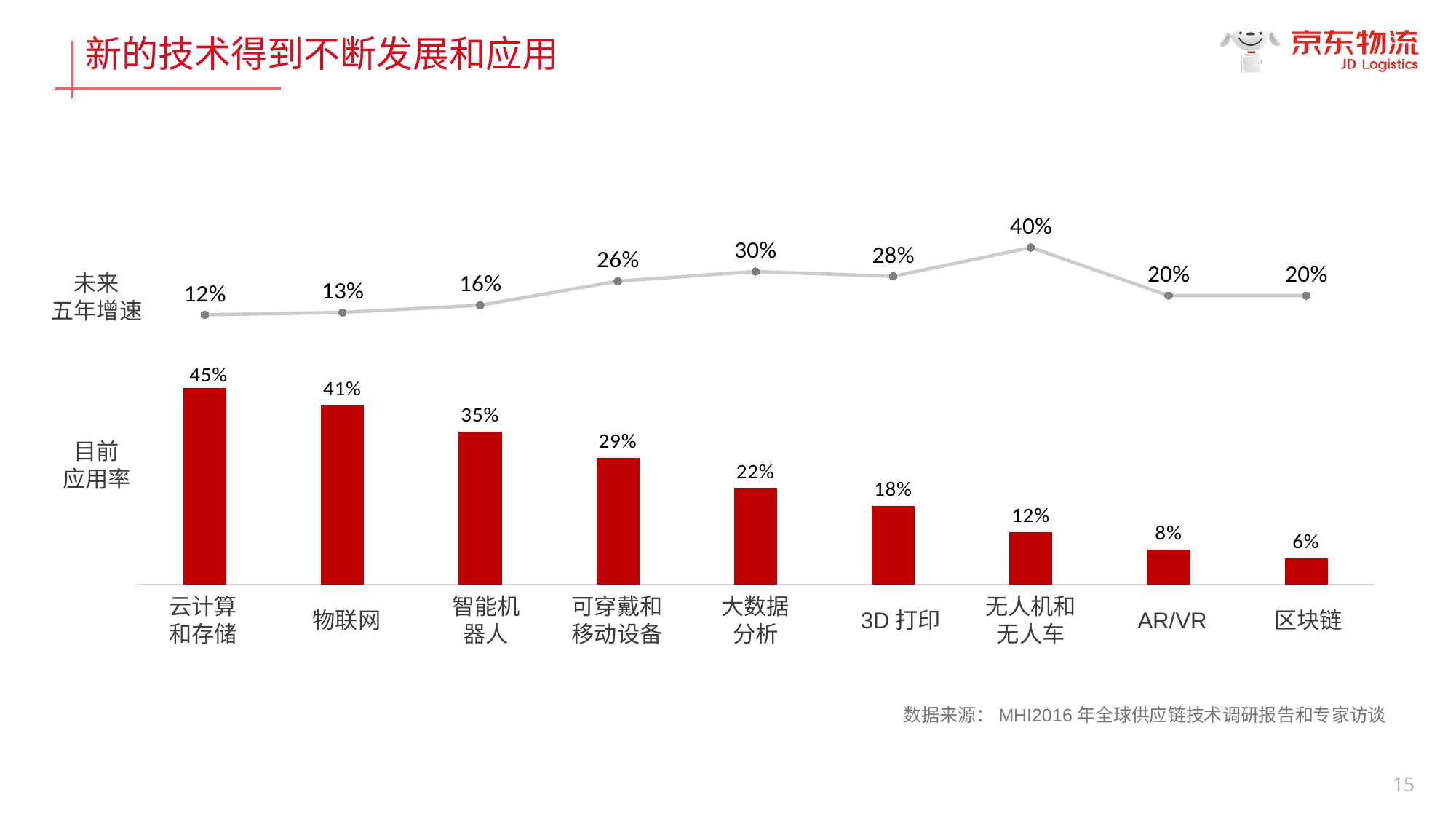
What kind of chart is used to show the current adoption rate (目前应用率)? Bar chart Which is larger: the future five-year growth rate of 可穿戴和移动设备 or of 3D 打印? 3D 打印 What is the future five-year growth rate (未来五年增速) for 无人机和无人车? 40% Which technology has the lowest current adoption rate (目前应用率)? 区块链 Do the current adoption rate (目前应用率) bars rise or fall from left to right along the x axis? Fall How many technologies are shown on the x axis? 9 What is the difference between the current adoption rates of 云计算和存储 and 物联网? 4% What is the future five-year growth rate (未来五年增速) for 大数据分析? 30% What is the current adoption rate (目前应用率) for 区块链? 6% Which technology has the highest future five-year growth rate (未来五年增速)? 无人机和无人车 What is the current adoption rate (目前应用率) for 云计算和存储? 45% How many data series does the chart show? 2